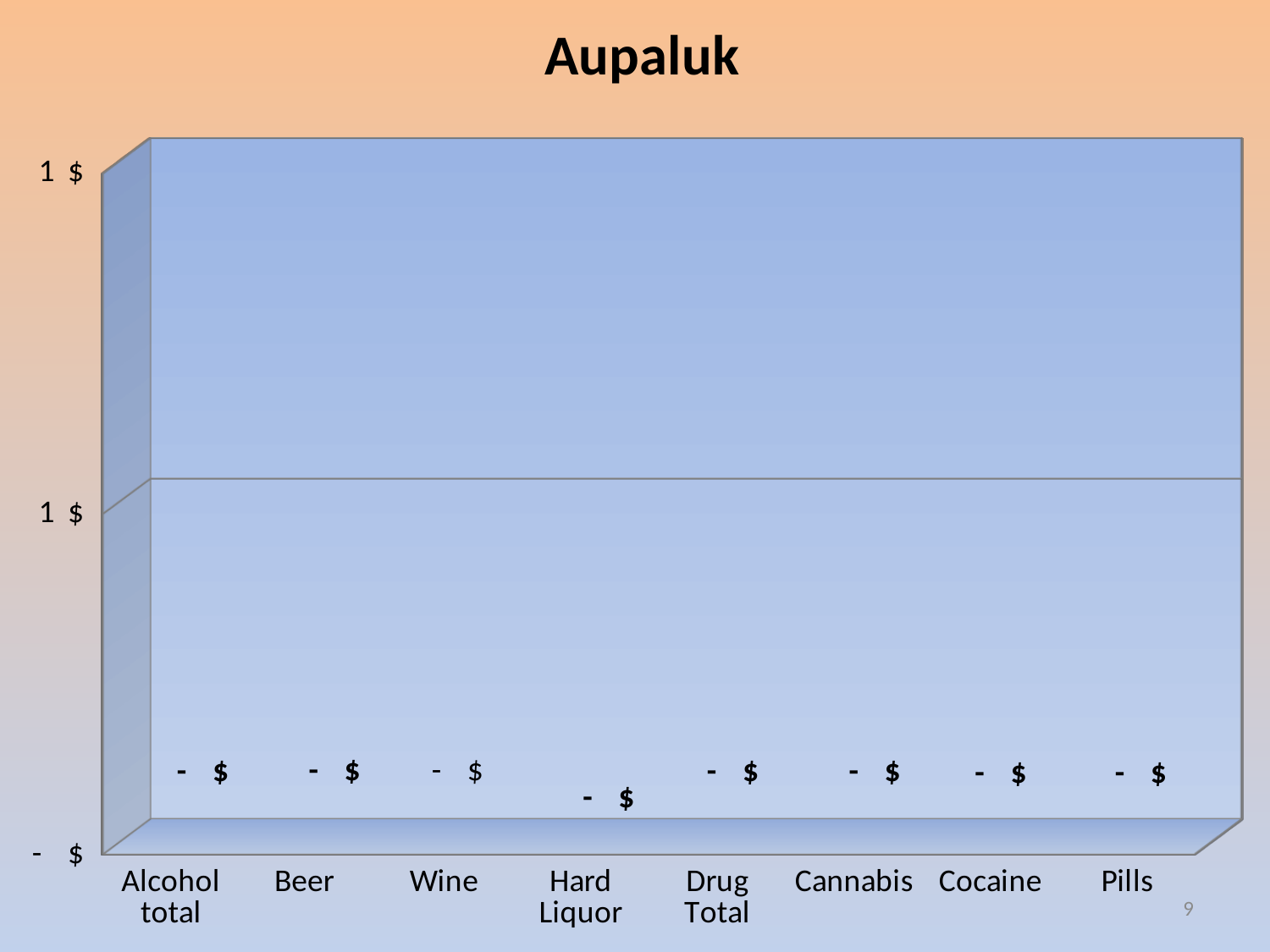
What data label is shown for Cannabis? - $ What is the label of the first category on the x axis? Alcohol total Which category comes immediately after Drug Total on the x axis? Cannabis What kind of chart is shown on the slide? bar chart What data label is shown for Alcohol total? - $ What is the title of the chart? Aupaluk How many categories are shown on the x axis of the chart? 8 What data label is shown for Hard Liquor? - $ What is the label of the last category on the x axis? Pills What data label is shown for Pills? - $